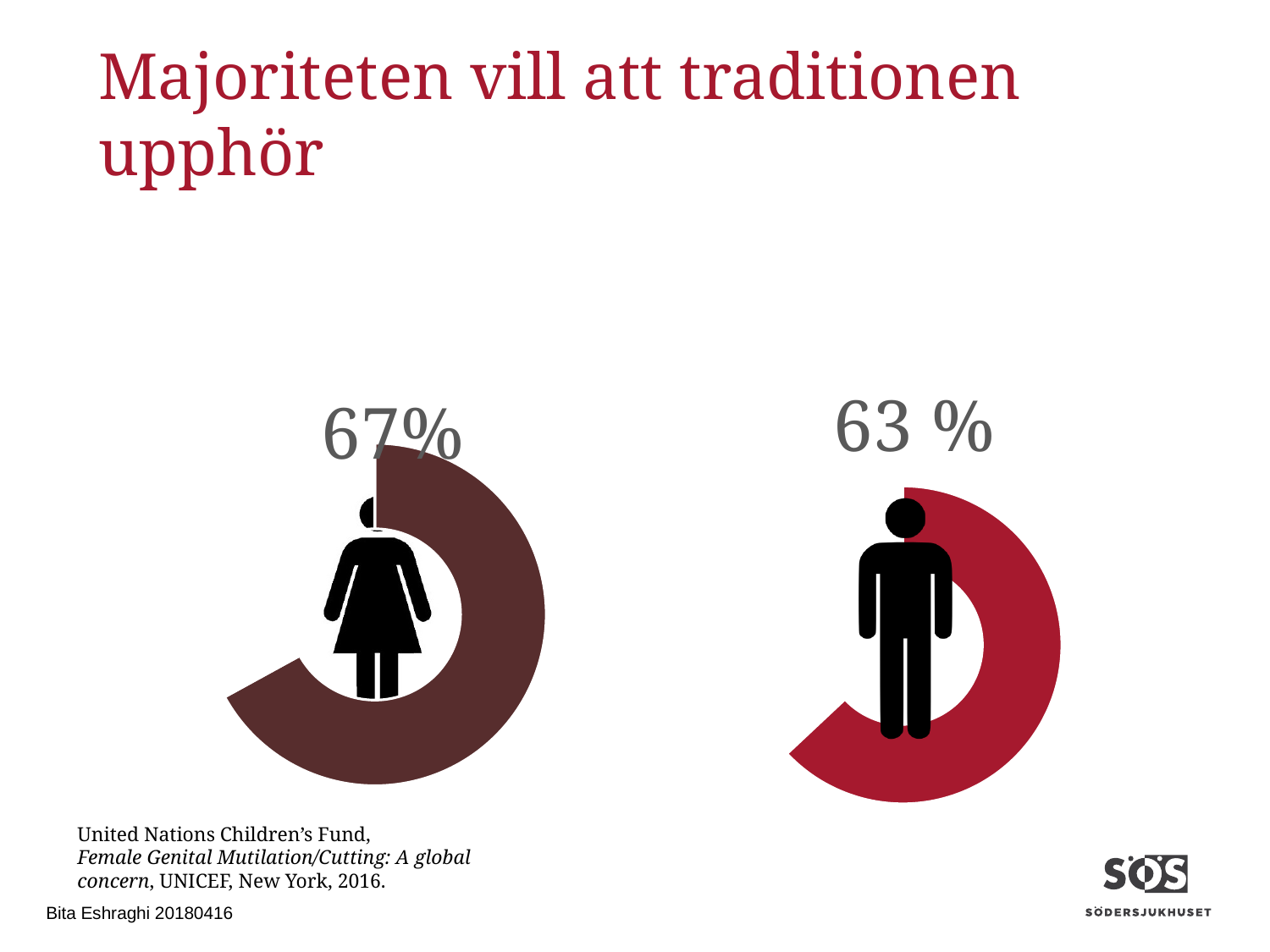
What is the title of the slide? Majoriteten vill att traditionen upphör Which organisation is cited as the source of the data on the slide? UNICEF (United Nations Children's Fund) Is the value shown on the right chart with the male figure greater or less than 50%? greater Which chart shows the higher percentage, the left one with the female figure or the right one with the male figure? The left one with the female figure How many charts are shown on the slide? 2 What kind of chart is used on this slide to show the percentages? Donut (ring) chart What value is shown on the left chart with the female figure? 67% What value is shown on the right chart with the male figure? 63 % What is the difference in percentage points between the value on the left chart (67%) and the value on the right chart (63 %)? 4 percentage points Which chart shows the lower percentage, the left one with the female figure or the right one with the male figure? The right one with the male figure Is the value shown on the left chart with the female figure greater or less than 50%? greater